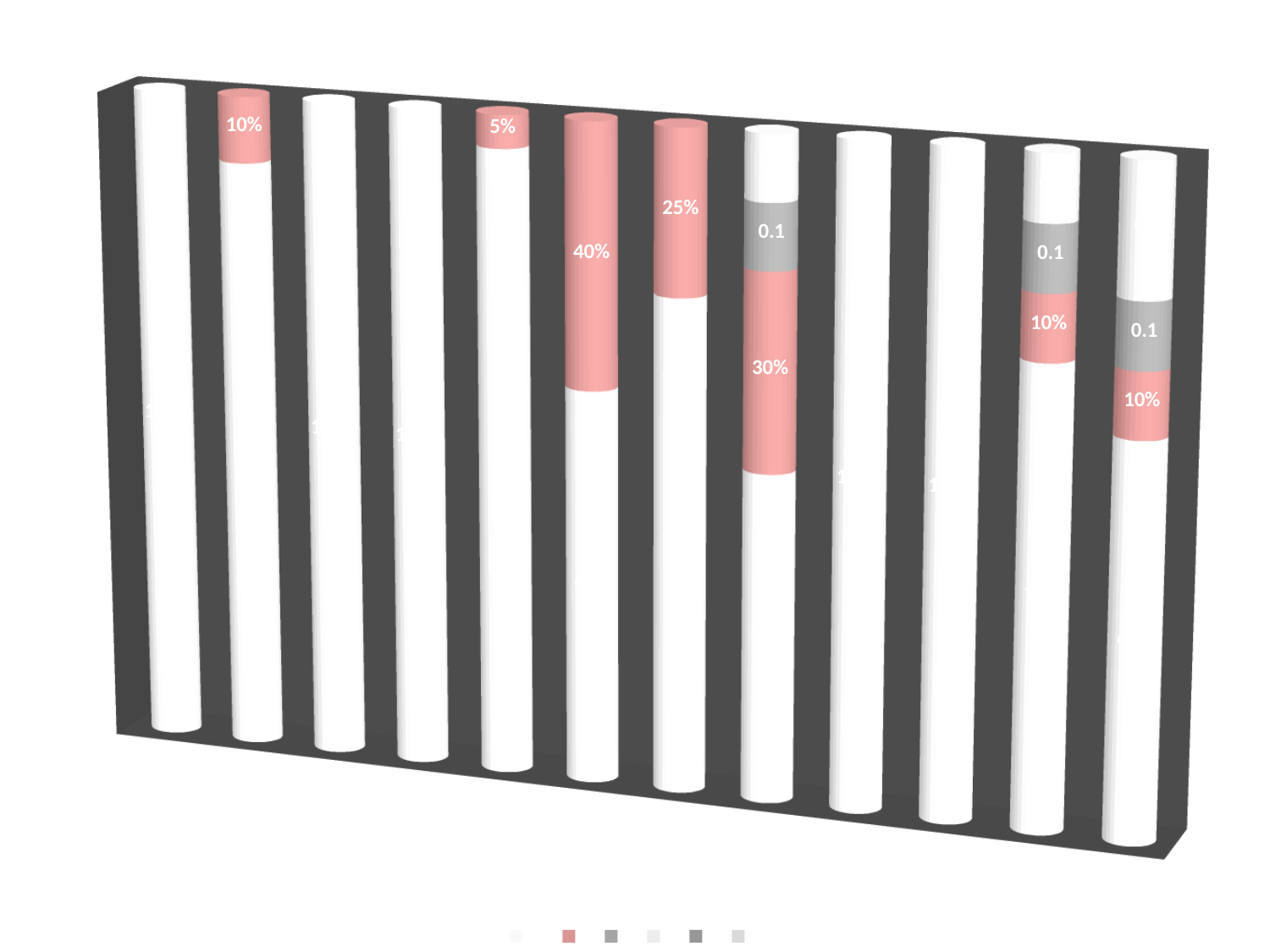
How many bars contain a grey segment labelled 0.1? 3 What value is labelled on the pink segment of the eighth bar from the left? 30% What value is labelled on the pink segment of the fifth bar from the left? 5% What kind of chart is shown on the slide? Stacked bar chart Which is larger, the pink segment of the sixth bar from the left or the pink segment of the seventh bar from the left? The sixth bar (40%) What value is labelled on the grey segment of the eighth bar from the left? 0.1 How many entries does the legend below the chart show? 6 What value is labelled on the pink segment of the sixth bar from the left? 40% How many bars are plotted in the chart? 12 Which bar has the largest pink segment? The sixth bar from the left (40%) What value is labelled on the pink segment of the second bar from the left? 10% What is the difference between the pink segment of the sixth bar from the left (40%) and the pink segment of the seventh bar from the left (25%)? 15%